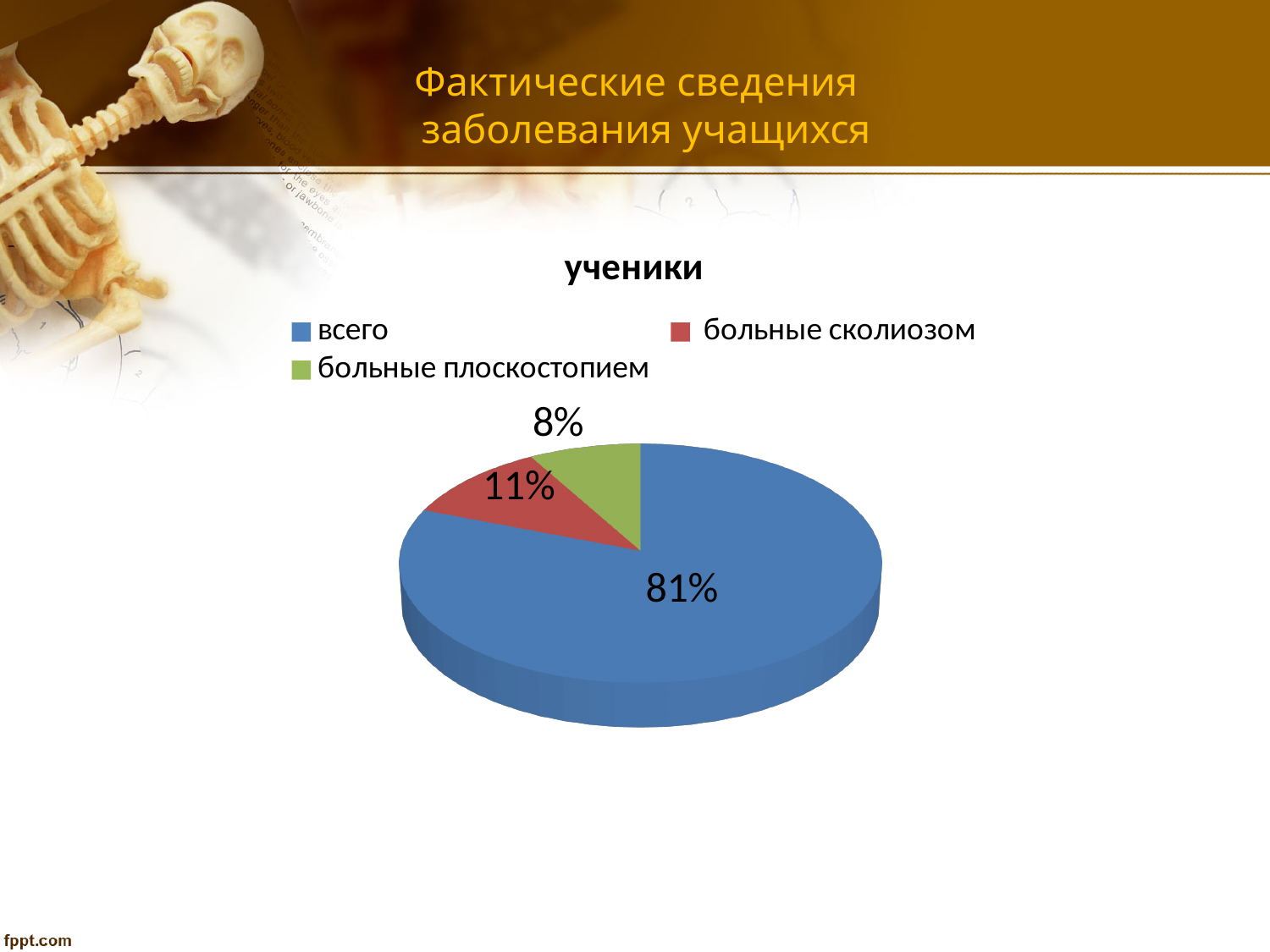
Which slice is larger: 'больные сколиозом' or 'больные плоскостопием'? больные сколиозом Which category has the largest slice of the pie? всего What share of the pie does the 'больные сколиозом' slice take? 11% What kind of chart is shown on the slide? pie chart What share of the pie does the 'больные плоскостопием' slice take? 8% What colour is the 'больные плоскостопием' slice? green What share of the pie does the 'всего' slice take? 81% What is the difference in percentage points between the 'всего' slice and the 'больные сколиозом' slice? 70 How many slices does the pie chart have? 3 How many entries does the legend list? 3 What is the title of the chart? ученики Which category has the smallest slice of the pie? больные плоскостопием